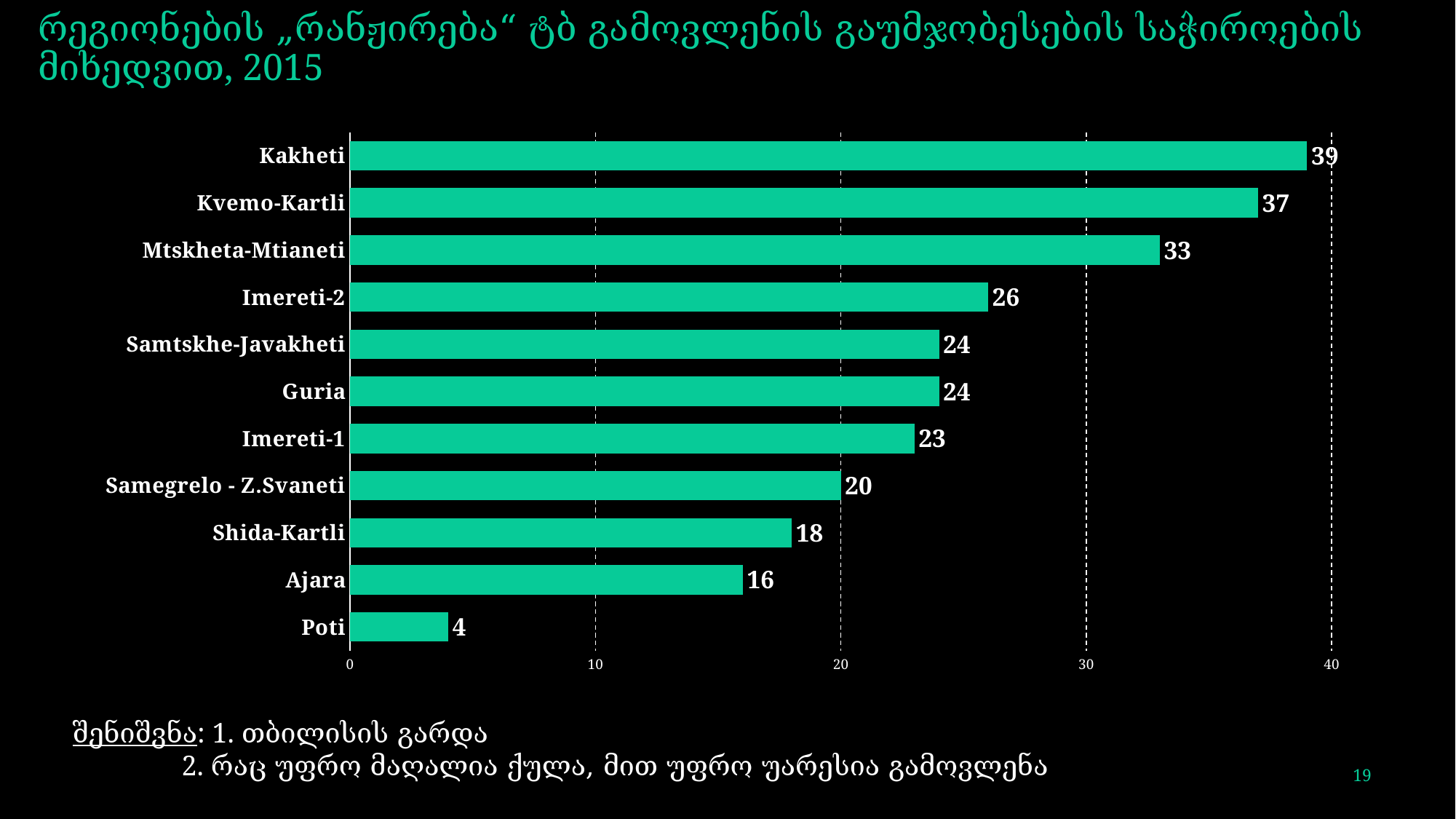
How many regions are shown in the chart? 11 Which region has the highest value? Kakheti Which two regions share the value 24? Samtskhe-Javakheti and Guria What is the value for Shida-Kartli? 18 What is the value for Poti? 4 What is the value for Kakheti? 39 What is the difference between the values for Imereti-2 and Ajara? 10 What is the difference between the values for Kvemo-Kartli and Mtskheta-Mtianeti? 4 Which is larger, the value for Imereti-1 or the value for Samegrelo - Z.Svaneti? Imereti-1 Is the value for Mtskheta-Mtianeti greater or less than 30? greater What kind of chart is shown on the slide? bar chart Which region has the lowest value? Poti